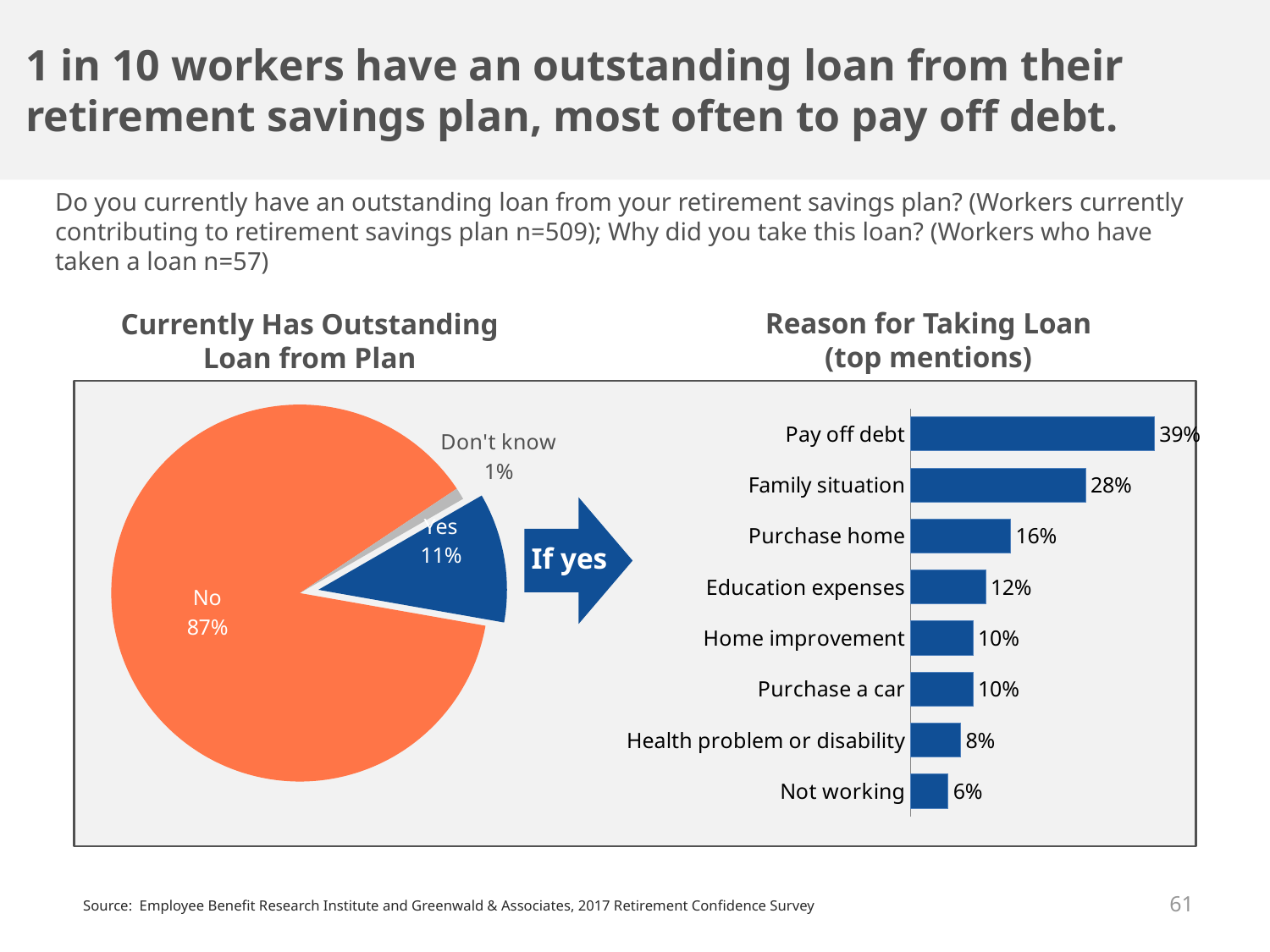
What kind of chart is 'Reason for Taking Loan (top mentions)'? Bar chart How many reasons are listed in the 'Reason for Taking Loan (top mentions)' chart? 8 What kind of chart is 'Currently Has Outstanding Loan from Plan'? Pie chart In the 'Reason for Taking Loan (top mentions)' chart, what is the value for Health problem or disability? 8% In the 'Reason for Taking Loan (top mentions)' chart, which reason has the lowest value? Not working In the 'Currently Has Outstanding Loan from Plan' chart, what percentage of workers answered No? 87% In the 'Reason for Taking Loan (top mentions)' chart, which is larger: Education expenses or Home improvement? Education expenses In the 'Reason for Taking Loan (top mentions)' chart, what is the difference between Pay off debt and Purchase home? 23% In the 'Reason for Taking Loan (top mentions)' chart, what is the value for Family situation? 28% In the 'Currently Has Outstanding Loan from Plan' chart, what share of the pie is 'Don't know'? 1% In the 'Reason for Taking Loan (top mentions)' chart, which reason has the highest value? Pay off debt In the 'Currently Has Outstanding Loan from Plan' chart, what percentage of workers answered Yes? 11%